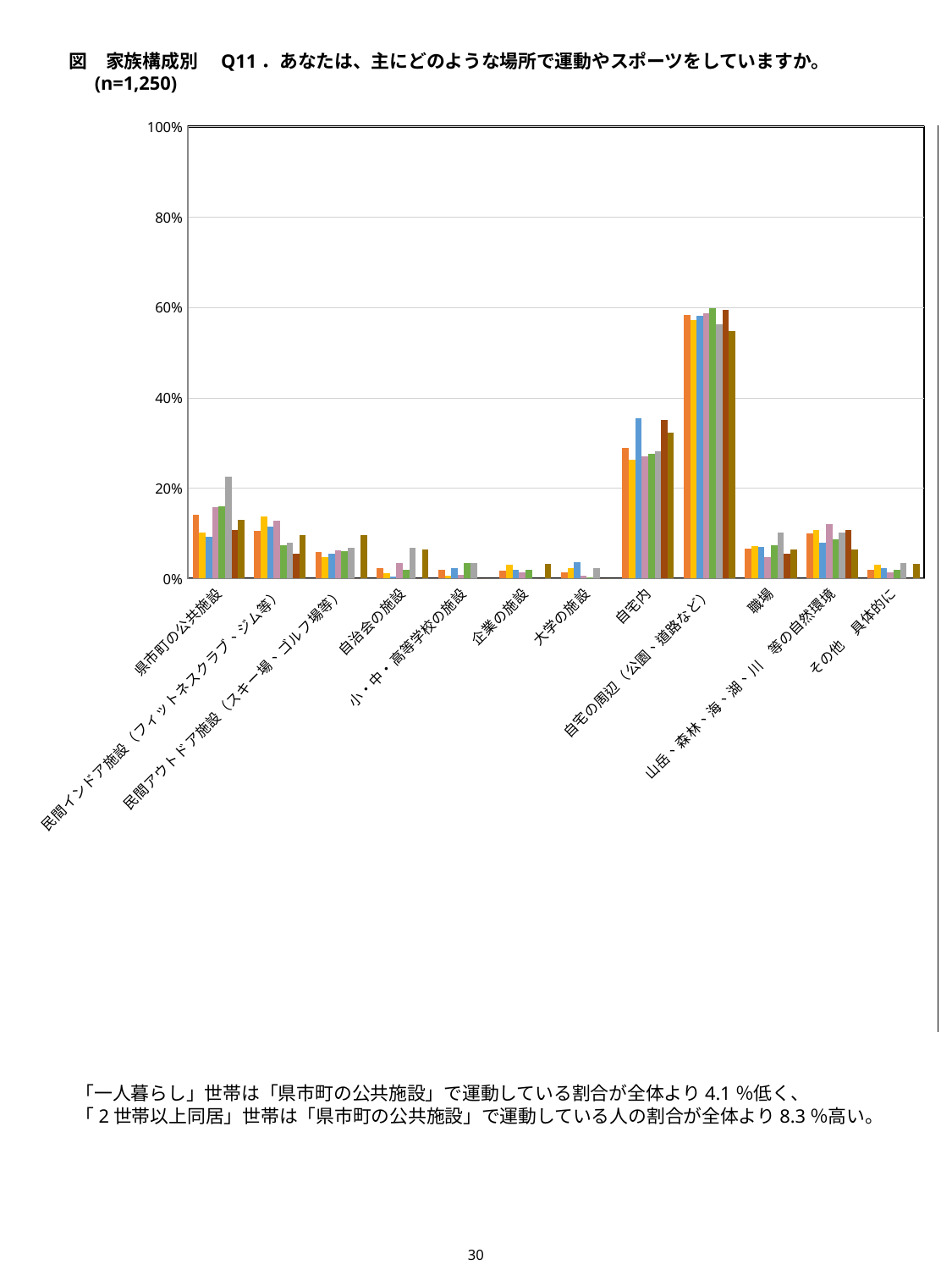
What is the sample size (n) stated for the chart? n=1,250 Are the values for 職場 greater or less than 20%? less Are the values for 大学の施設 greater or less than 20%? less What is the maximum value shown on the y axis of the chart? 100% Are the values for 県市町の公共施設 greater or less than 40%? less Which category has larger values, 自宅内 or 職場? 自宅内 What kind of chart is shown on the slide? bar chart How many categories are shown along the x axis of the chart? 12 Which category has the highest values in the chart? 自宅の周辺（公園、道路など） Which category has larger values, 自宅の周辺（公園、道路など） or 自宅内? 自宅の周辺（公園、道路など）